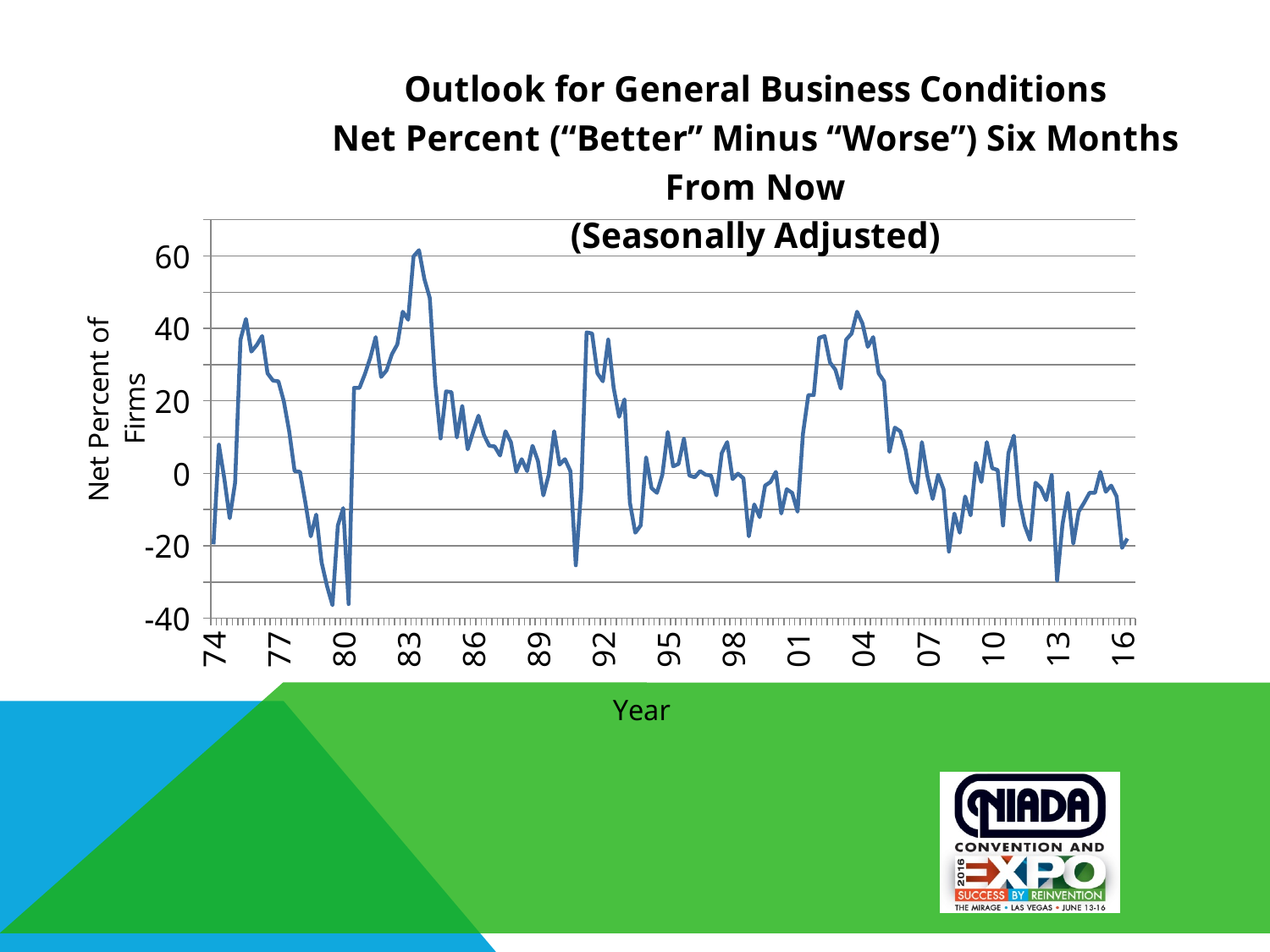
What is the label on the vertical axis of the chart? Net Percent of Firms What is the label on the horizontal axis of the chart? Year Is the dip in the line near 13 greater or less than -20? less Is the peak value of the line near 04 greater or less than 20? greater What kind of chart is shown on the slide? Line chart Is the peak value of the line near 83 greater or less than 40? greater Around which labeled year does the line reach its highest value? 83 Between the 83 and 86 tick marks, does the line generally rise or fall? fall Around which labeled year does the line reach its lowest value? 80 Between the 80 and 83 tick marks, does the line generally rise or fall? rise How many year labels are shown along the horizontal axis? 15